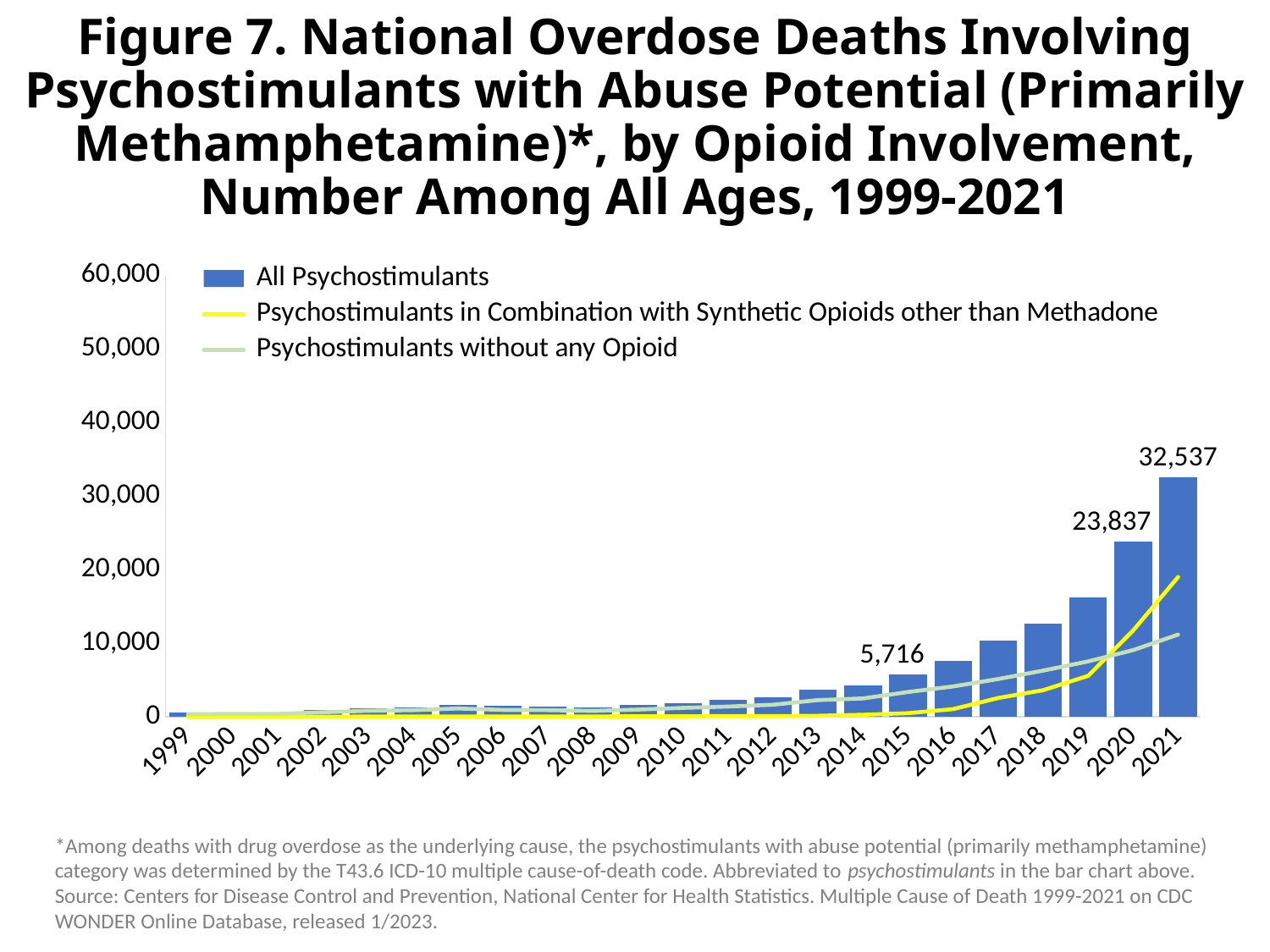
What is the value for All Psychostimulants in 2021? 32,537 What is the value for All Psychostimulants in 2015? 5,716 Do the All Psychostimulants values generally rise or fall from 1999 to 2021? rise How many years are shown on the x axis? 23 Is the value for All Psychostimulants in 2019 greater or less than 10,000? greater Is the value for Psychostimulants in Combination with Synthetic Opioids other than Methadone in 2021 greater or less than 20,000? less How many series does the legend list? 3 What is the difference between the All Psychostimulants values for 2021 and 2020? 8,700 What is the difference between the All Psychostimulants values for 2020 and 2015? 18,121 What is the value for All Psychostimulants in 2020? 23,837 Which year has the highest value for All Psychostimulants? 2021 Which is larger, the All Psychostimulants value for 2020 or for 2015? 2020